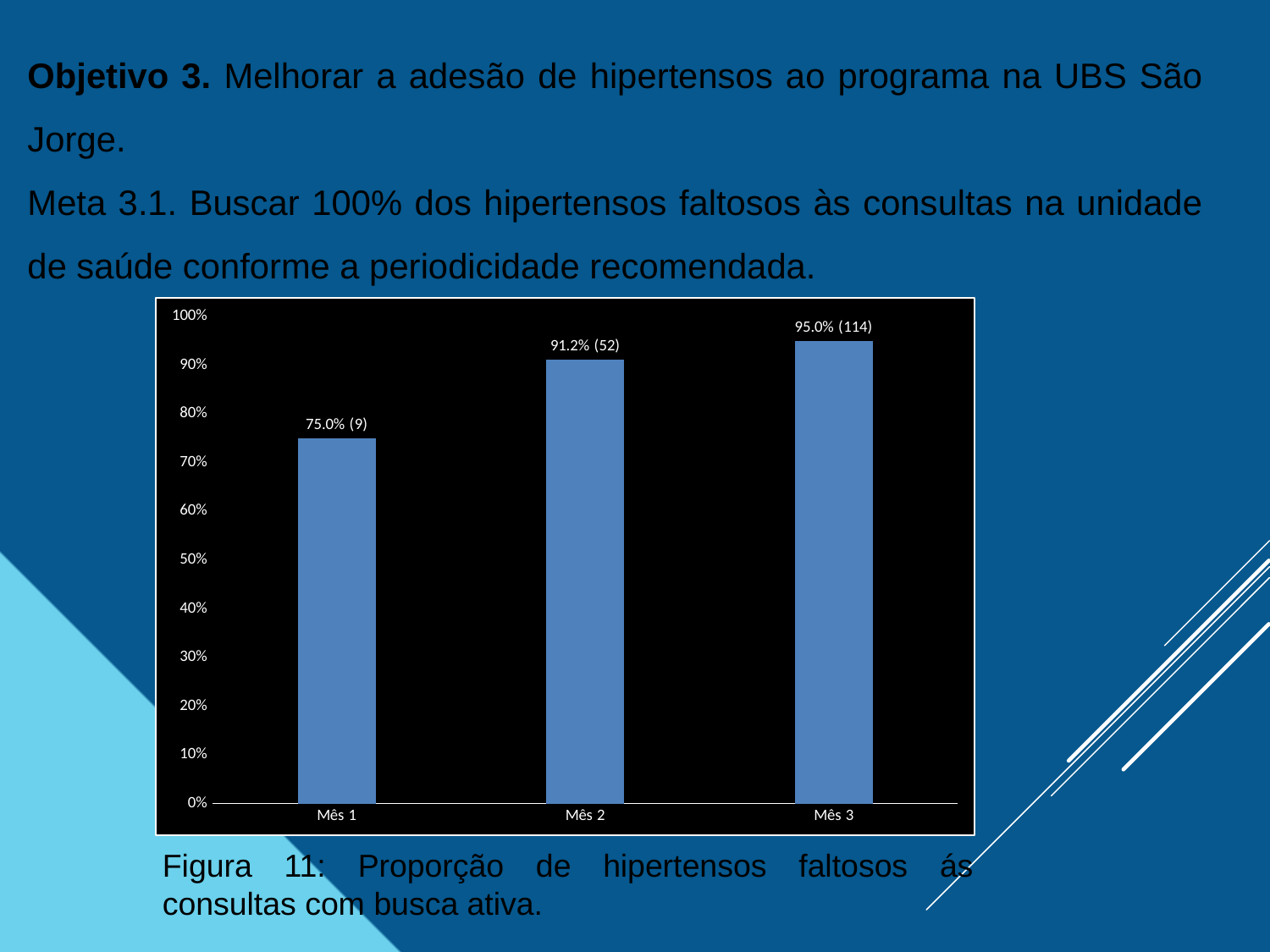
Which is larger, the value for Mês 1 or the value for Mês 2? Mês 2 Which month has the highest value? Mês 3 What is the difference in percentage points between Mês 3 and Mês 1? 20.0% Which month has the lowest value? Mês 1 What is the value shown for Mês 1? 75.0% (9) Do the values rise or fall from Mês 1 to Mês 3? rise Is the value for Mês 2 greater or less than 90%? greater How many months are shown on the x axis? 3 What is the value shown for Mês 2? 91.2% (52) What is the value shown for Mês 3? 95.0% (114) What is the figure number given in the caption below the chart? Figura 11 What kind of chart is shown on the slide? bar chart